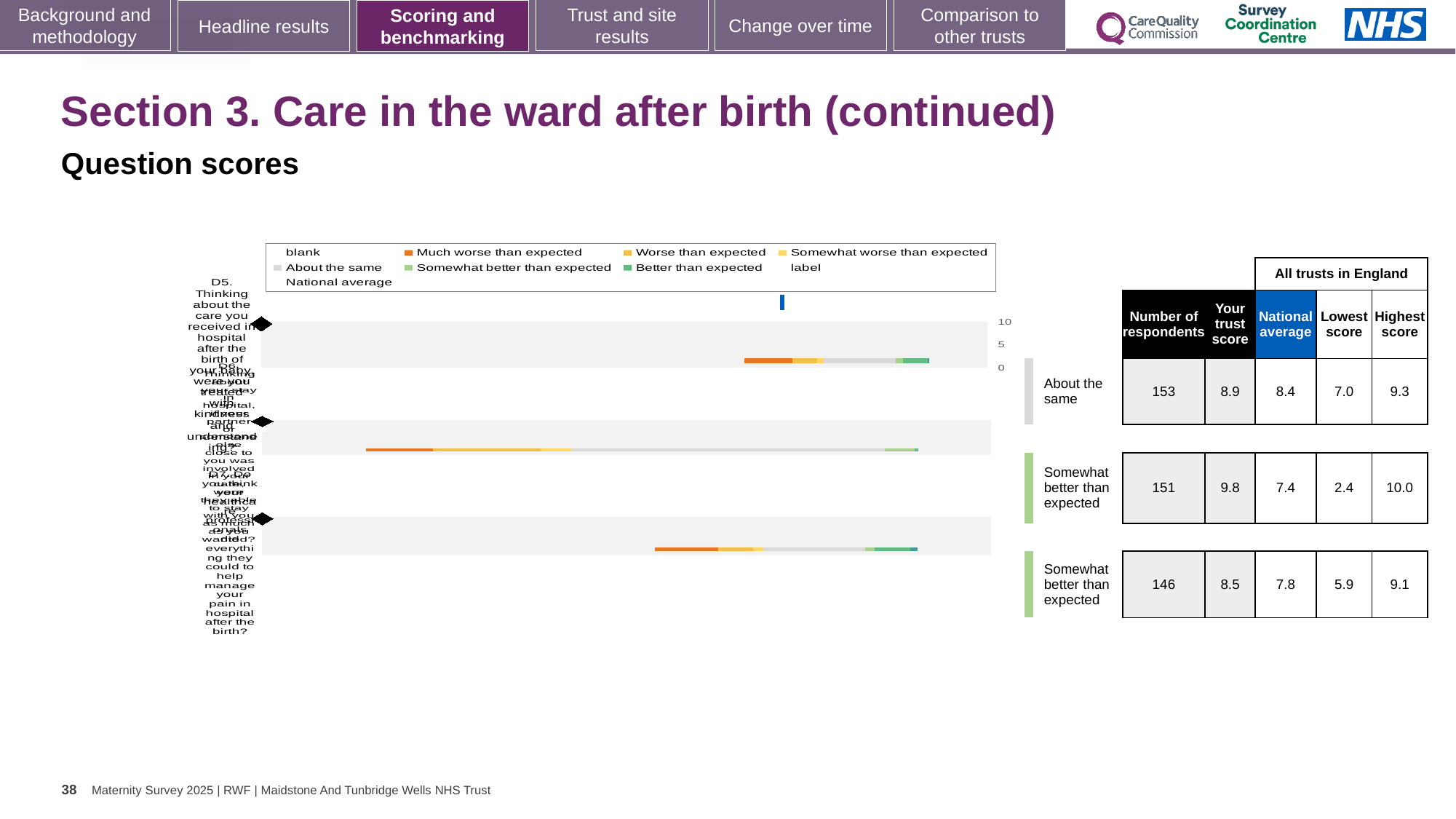
How many question bars are plotted in the chart? 3 In the table beside the chart, what is the highest score for the second row? 10.0 In the table beside the chart, what is 'Your trust score' for the first row (D5)? 8.9 What kind of chart is shown on the slide? bar chart What colour represents 'Much worse than expected' in the chart legend? orange How many entries does the chart's legend list? 9 In the table beside the chart, what is the difference between the trust score and the national average for the first row (8.9 vs 8.4)? 0.5 In the table beside the chart, what is the national average for the second row? 7.4 In the table beside the chart, what is the number of respondents for the first row (D5)? 153 In the table beside the chart, which row has the highest 'Your trust score'? the second row (9.8) What is the highest value shown on the chart's score axis? 10 In the table beside the chart, what is the lowest score for the third row? 5.9